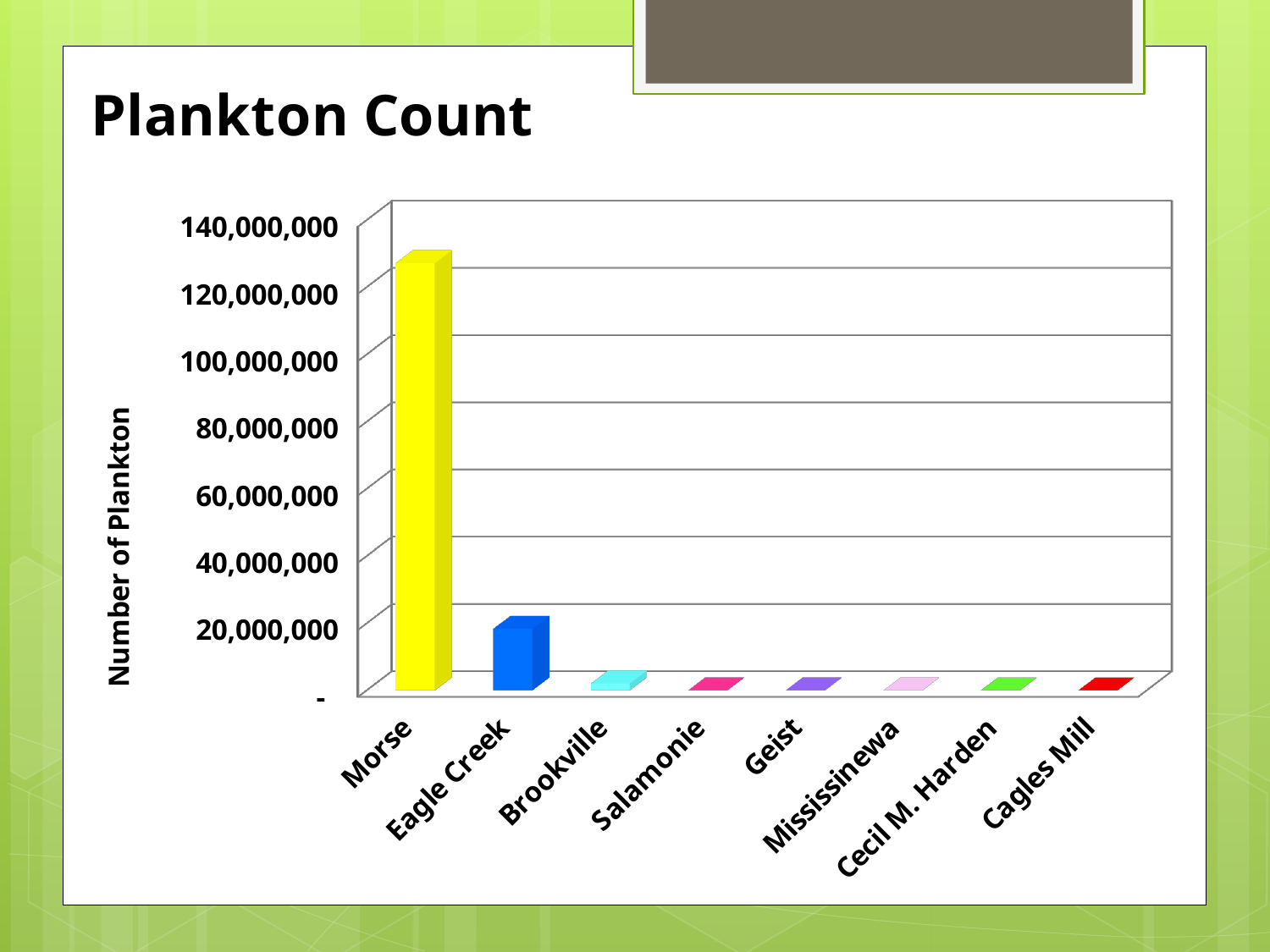
How many categories are plotted on the x axis? 8 Which is larger, the value for Morse or the value for Eagle Creek? Morse Is the value for Brookville greater or less than 20,000,000? less Is the value for Morse greater or less than 140,000,000? less Which is larger, the value for Eagle Creek or the value for Cagles Mill? Eagle Creek What is the title of the chart's vertical axis? Number of Plankton Is the value for Morse greater or less than 120,000,000? greater What kind of chart is shown on the slide? bar chart What colour is the bar for Morse? yellow Which category has the highest number of plankton? Morse Which is larger, the value for Eagle Creek or the value for Brookville? Eagle Creek